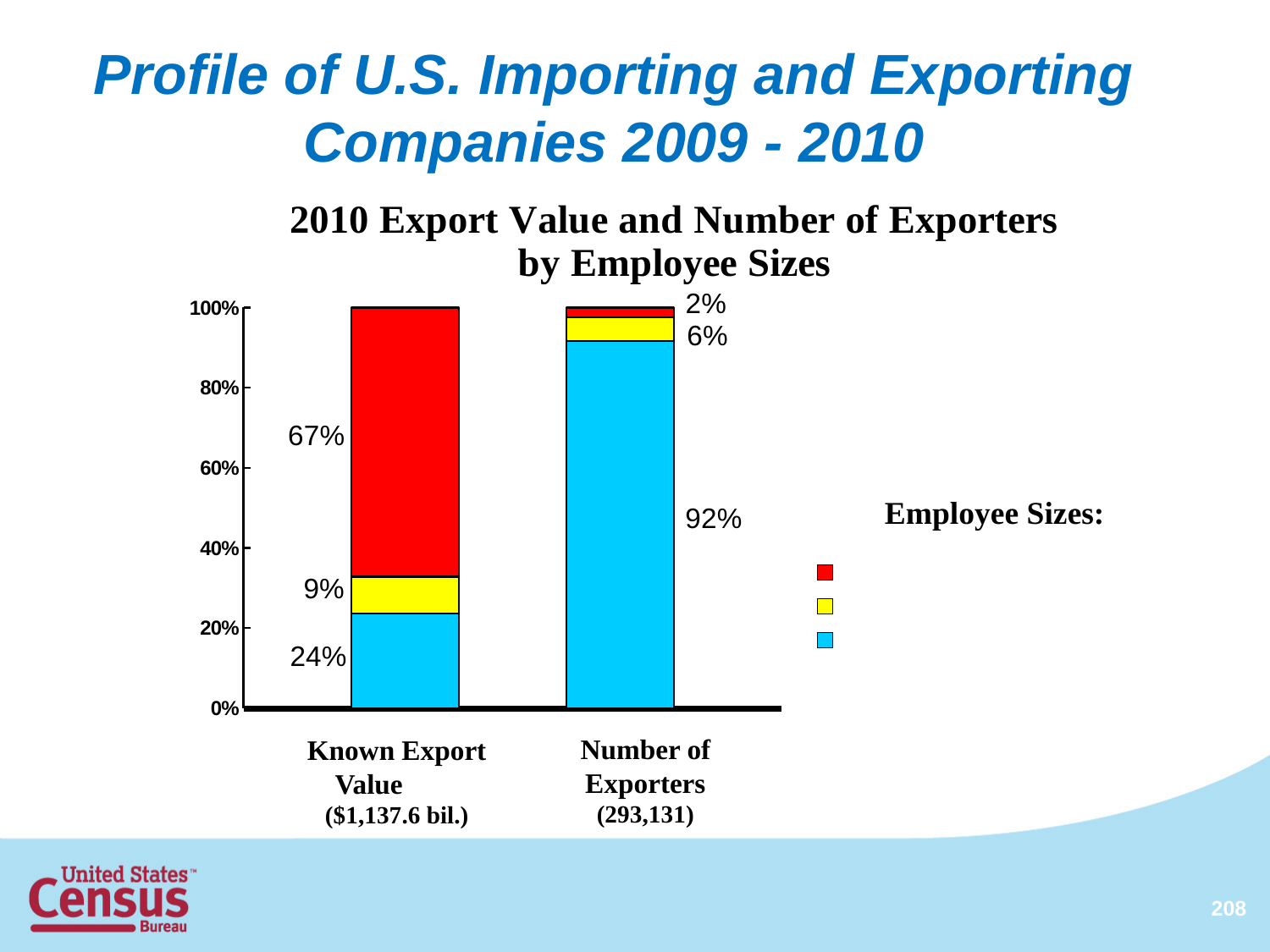
How many colour entries does the legend show? 3 What percentage does the red segment represent in the Known Export Value bar? 67% What kind of chart is shown on the slide? stacked bar chart What is the difference between the red segment's share in the Known Export Value bar and in the Number of Exporters bar? 65 percentage points Which segment is the largest in the Number of Exporters bar? blue (92%) What percentage does the yellow segment represent in the Number of Exporters bar? 6% How many bars (categories) are plotted in the chart? 2 Is the blue segment larger in the Known Export Value bar or in the Number of Exporters bar? Number of Exporters Which segment is the smallest in the Known Export Value bar? yellow (9%) What percentage does the blue segment represent in the Number of Exporters bar? 92% What percentage does the blue segment represent in the Known Export Value bar? 24% What is the title of the chart? 2010 Export Value and Number of Exporters by Employee Sizes